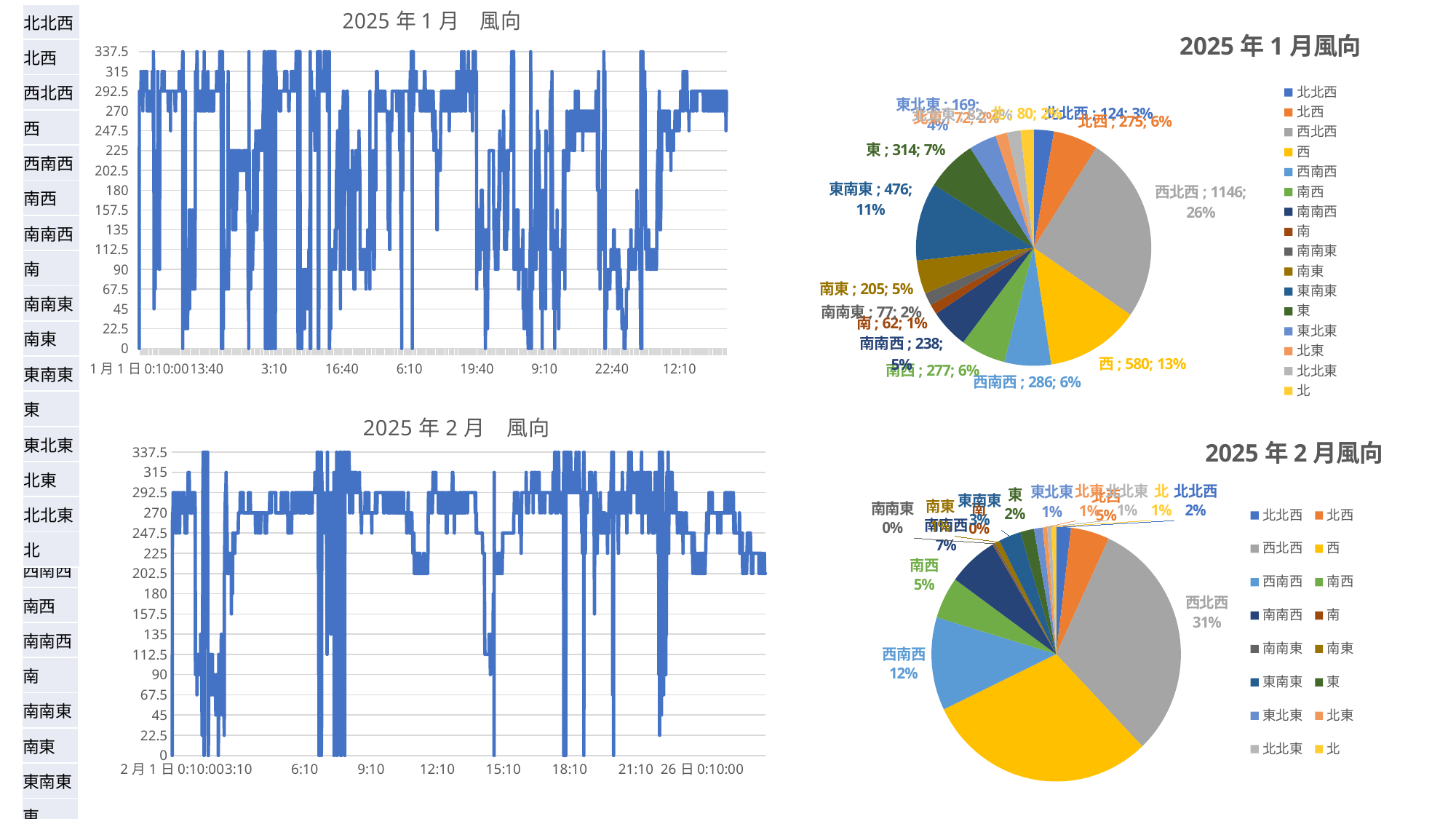
What kind of chart is the top-left chart titled 2025年1月 風向? line chart In the pie chart titled 2025年1月風向, what share of the pie does 西北西 have? 26% In the pie chart titled 2025年1月風向, which is larger, 東南東 or 東? 東南東 How many entries does the legend of the pie chart titled 2025年1月風向 list? 16 In the pie chart titled 2025年2月風向, what share of the pie does 西南西 have? 12% In the pie chart titled 2025年1月風向, which category has the largest slice? 西北西 In the pie chart titled 2025年1月風向, what is the value for 南? 62 In the pie chart titled 2025年1月風向, what is the value for 東南東? 476 In the pie chart titled 2025年1月風向, what is the difference between the values for 西北西 and 西? 566 In the pie chart titled 2025年1月風向, what is the value for 西北西? 1146 In the pie chart titled 2025年2月風向, what share of the pie does 西北西 have? 31% What is the title of the bottom-left line chart? 2025年2月 風向